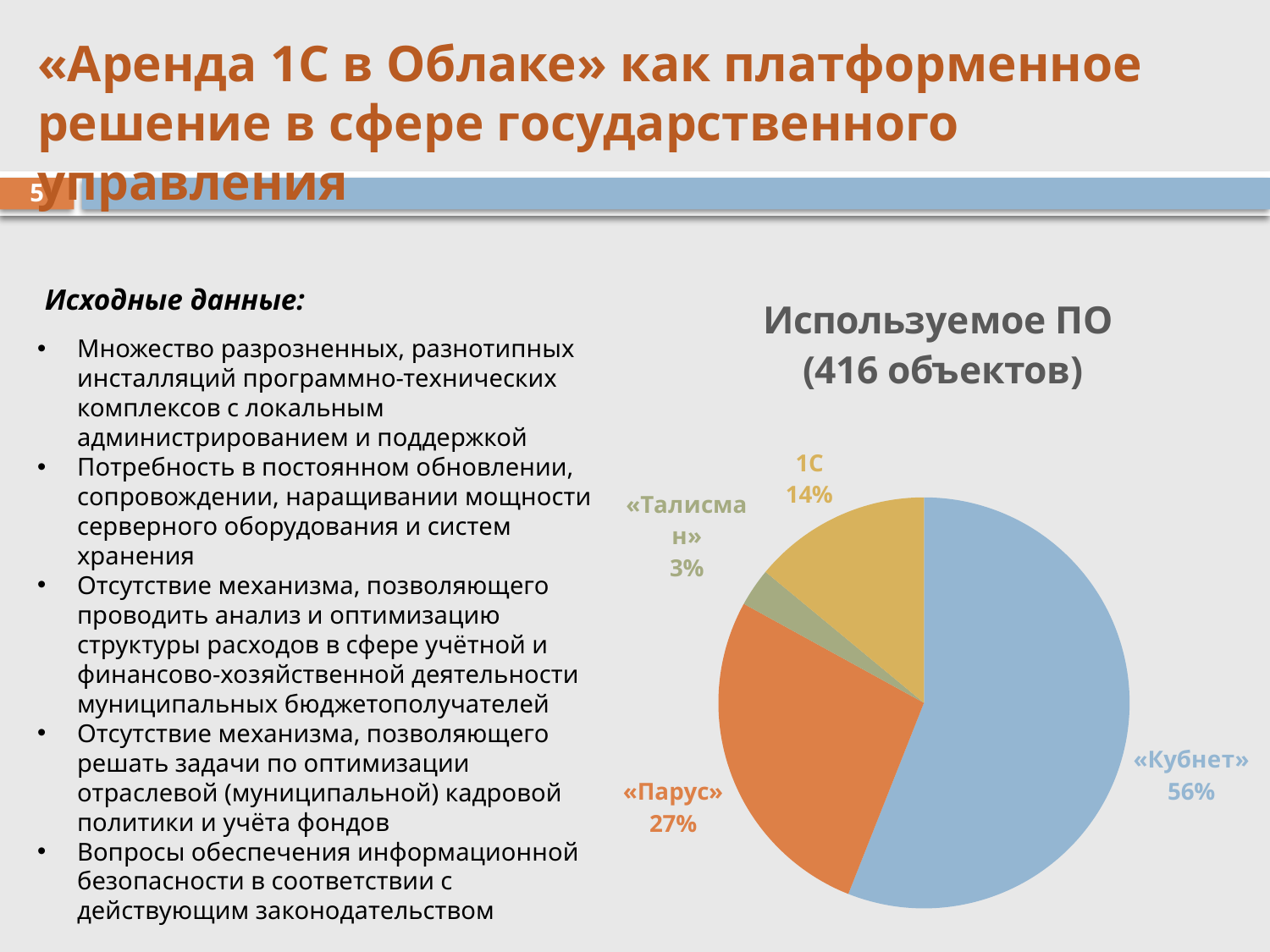
What is the difference in percentage points between «Кубнет» and «Парус»? 29 How many slices does the pie chart have? 4 What share of the pie does «Талисман» have? 3% What share of the pie does «Кубнет» have? 56% What is the title of the chart? Используемое ПО (416 объектов) Which category has the largest slice of the pie? «Кубнет» What share of the pie does «Парус» have? 27% What share of the pie does 1С have? 14% Which category has the smallest slice of the pie? «Талисман» What kind of chart is shown on the slide? pie chart Which is larger, the share for 1С or the share for «Парус»? «Парус» What colour is the «Кубнет» slice? blue